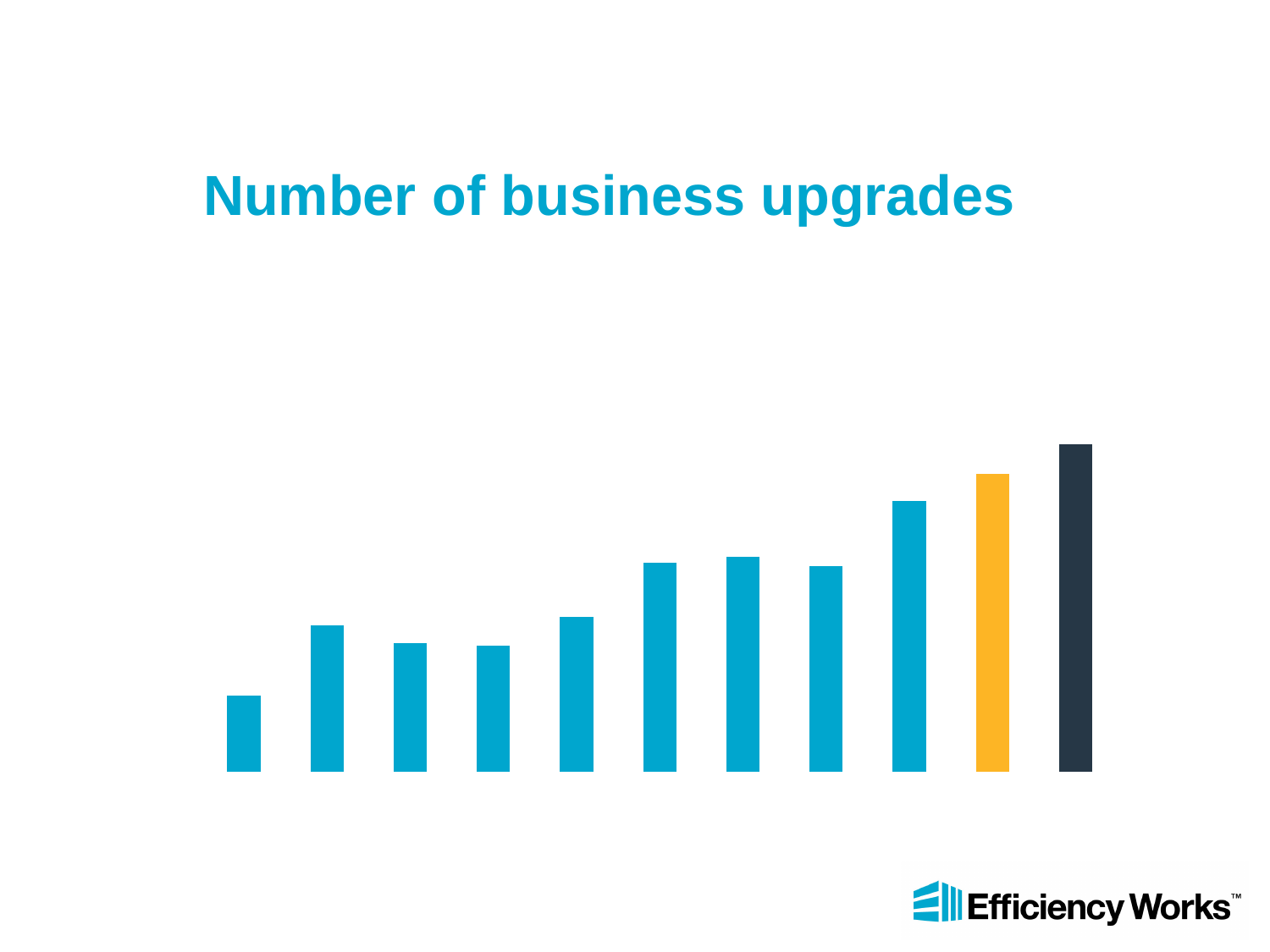
Which is taller, the sixth bar or the seventh bar from the left? the seventh bar Which is taller, the orange bar or the dark navy bar? the dark navy bar What colour is the second-to-last bar in the chart? orange What is the title of the chart? Number of business upgrades What kind of chart is shown on the slide? bar chart Which bar is the tallest in the chart? the last (rightmost) bar Do the bar heights generally rise or fall from left to right? rise How many bars does the chart contain? 11 Which bar is the shortest in the chart? the first (leftmost) bar Which is taller, the ninth bar or the tenth bar from the left? the tenth bar